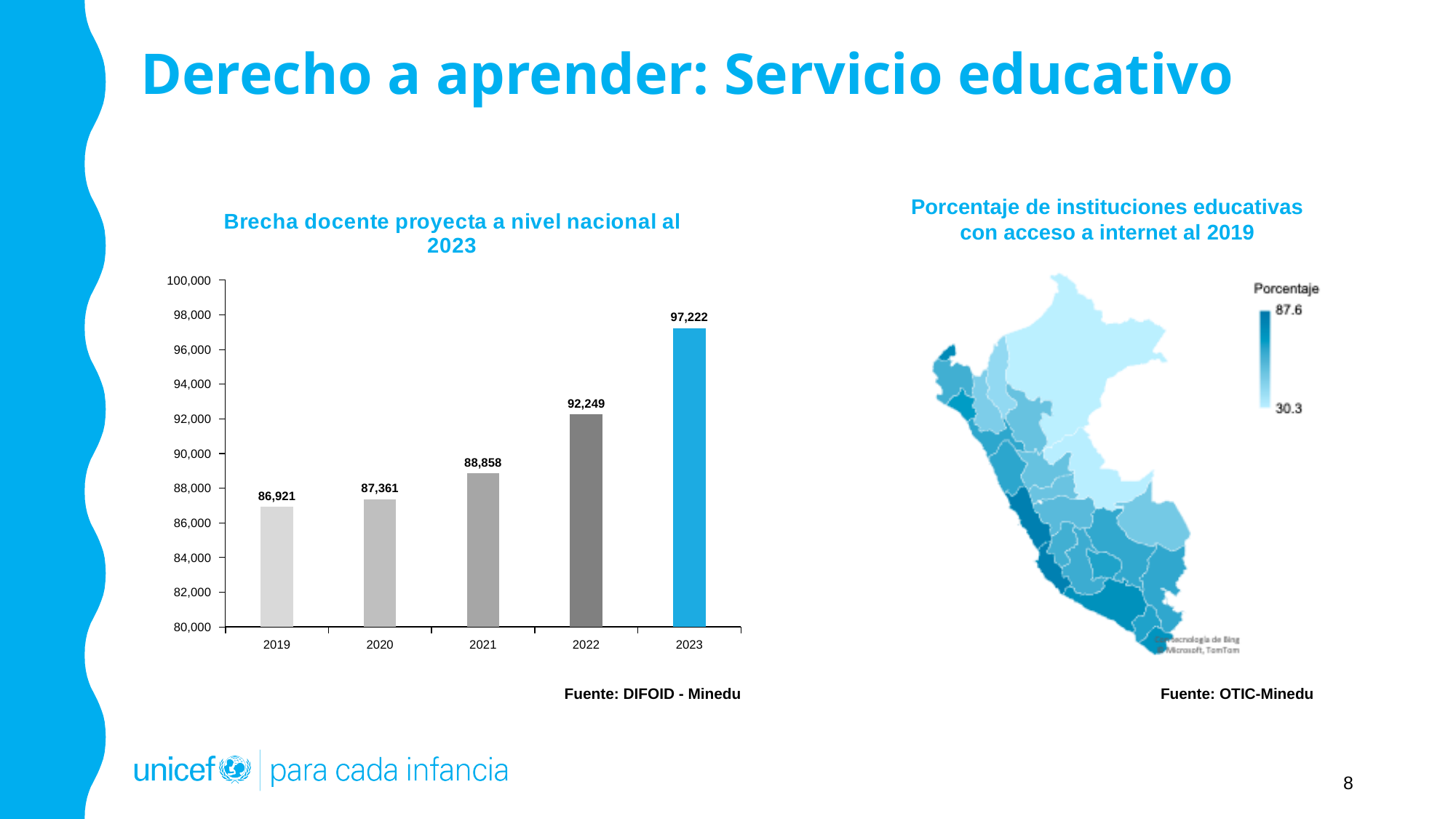
In the chart 'Brecha docente proyecta a nivel nacional al 2023', what is the value for 2022? 92,249 In the chart 'Brecha docente proyecta a nivel nacional al 2023', is the value for 2022 greater or less than 90,000? greater In the chart 'Brecha docente proyecta a nivel nacional al 2023', which year has the lowest value? 2019 What kind of chart is 'Brecha docente proyecta a nivel nacional al 2023'? bar chart In the chart 'Brecha docente proyecta a nivel nacional al 2023', what is the value for 2021? 88,858 In the chart 'Brecha docente proyecta a nivel nacional al 2023', what is the difference between the values for 2023 and 2019? 10,301 In the chart 'Brecha docente proyecta a nivel nacional al 2023', which year has the highest value? 2023 In the chart 'Brecha docente proyecta a nivel nacional al 2023', do the values rise or fall from 2019 to 2023? rise In the chart 'Brecha docente proyecta a nivel nacional al 2023', what is the difference between the values for 2022 and 2021? 3,391 In the chart 'Brecha docente proyecta a nivel nacional al 2023', what is the value for 2019? 86,921 How many years are shown on the x axis of the chart 'Brecha docente proyecta a nivel nacional al 2023'? 5 In the chart 'Brecha docente proyecta a nivel nacional al 2023', which is larger, the value for 2020 or the value for 2021? 2021